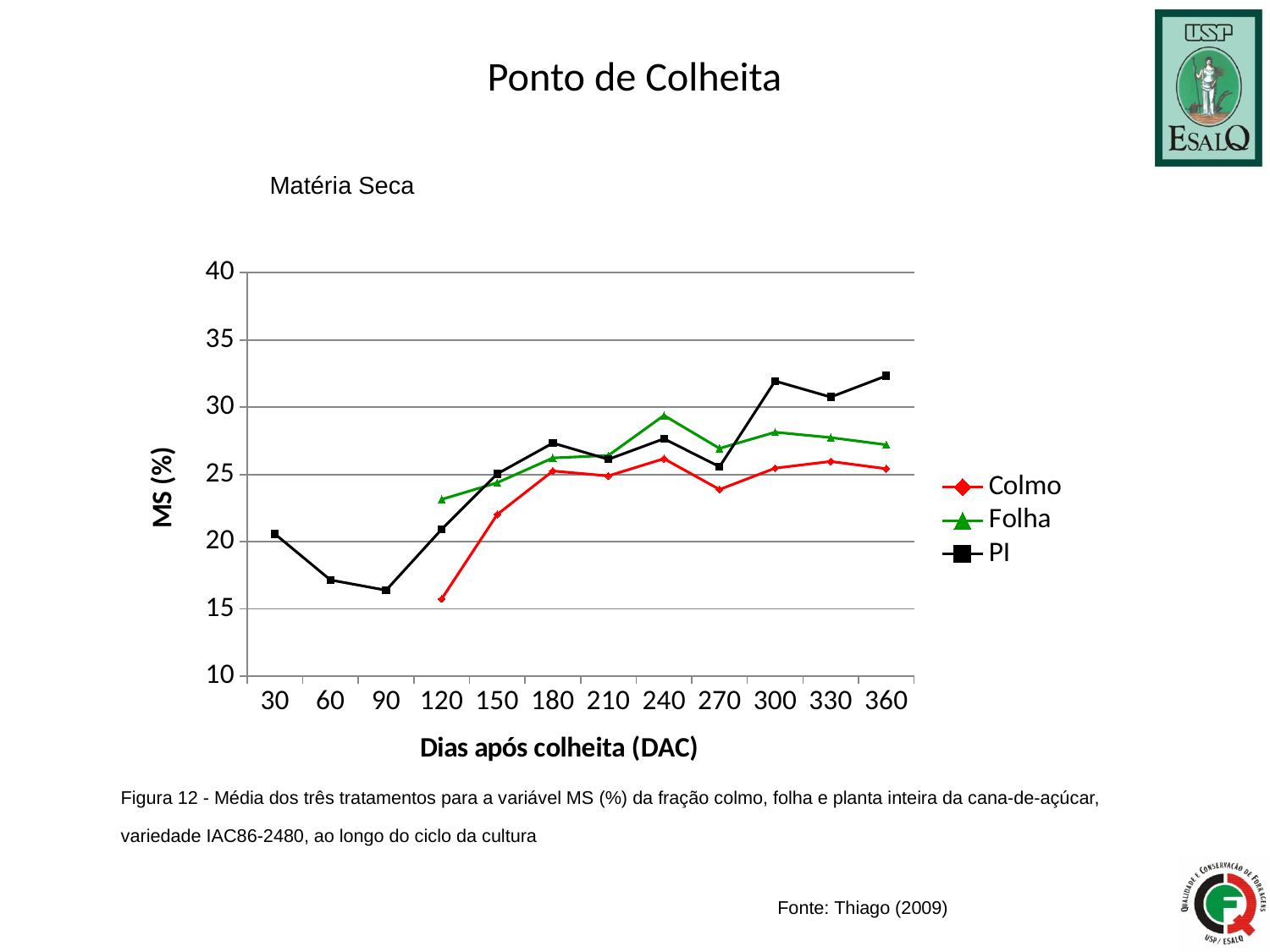
Is the value for PI at 90 DAC greater or less than 20? less How many series does the legend list? 3 Is the value for PI at 360 DAC greater or less than 30? greater At 360 DAC, which series has the larger value, PI or Colmo? PI How many DAC points are shown on the x axis? 12 Does the Colmo series rise or fall between 120 and 180 DAC? rise At which DAC does the PI series reach its lowest value? 90 At which DAC does the Folha series reach its highest value? 240 What is the title of the y axis? MS (%) Is the value for Colmo at 120 DAC greater or less than 20? less What kind of chart is shown on the slide? line chart Which series has the lowest value at 120 DAC? Colmo